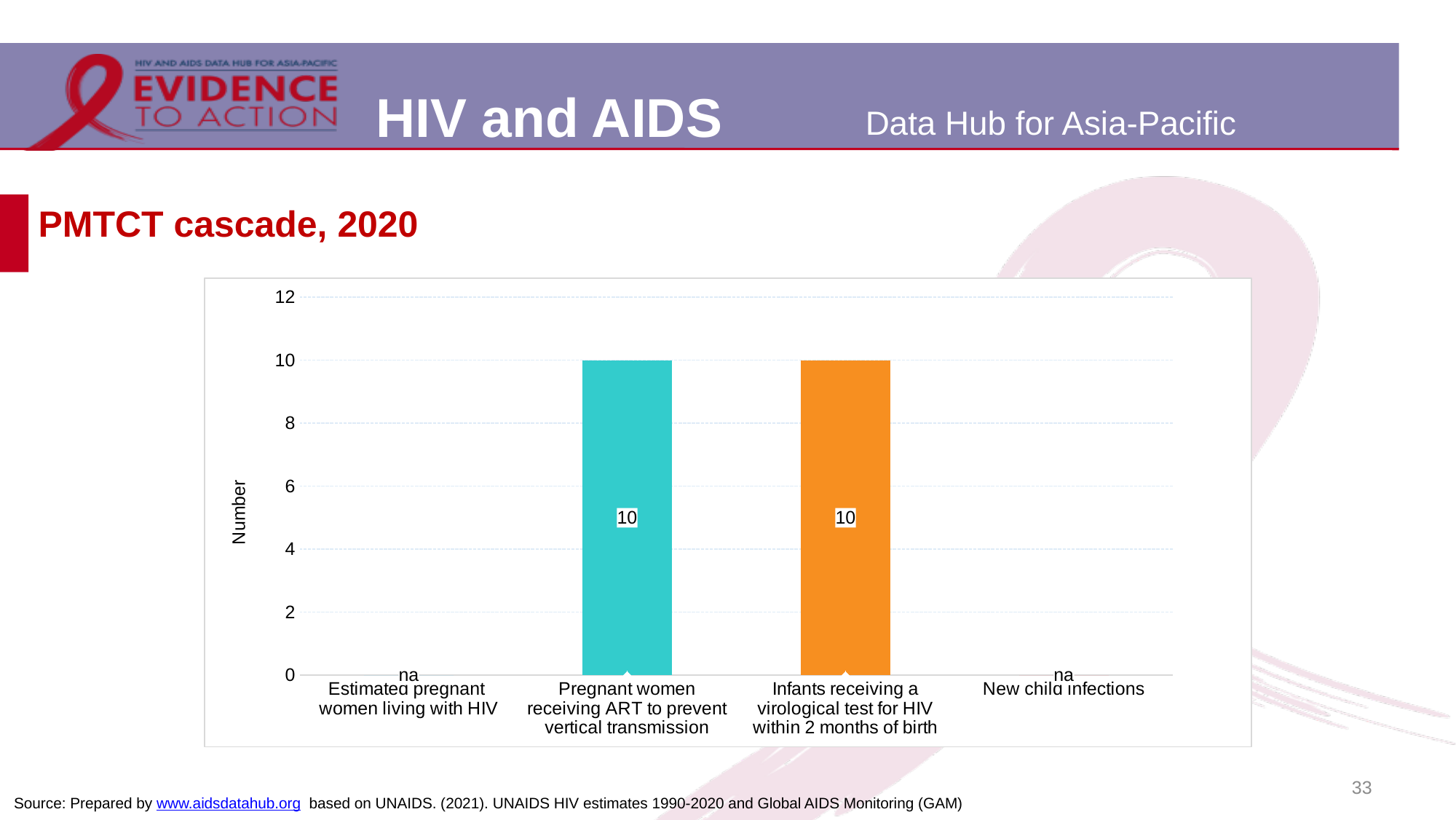
What is the label of the y axis? Number What is the value for Infants receiving a virological test for HIV within 2 months of birth? 10 What kind of chart is this? bar chart What is the difference between the value for Pregnant women receiving ART to prevent vertical transmission and the value for Infants receiving a virological test for HIV within 2 months of birth? 0 Is the value for Pregnant women receiving ART to prevent vertical transmission greater or less than 8? greater What label is shown for Estimated pregnant women living with HIV? na What is the value for Pregnant women receiving ART to prevent vertical transmission? 10 What is the title of the chart? PMTCT cascade, 2020 Is the value for Infants receiving a virological test for HIV within 2 months of birth greater or less than 12? less What label is shown for New child infections? na How many categories have a plotted bar with a numeric value? 2 How many categories are shown on the x axis? 4